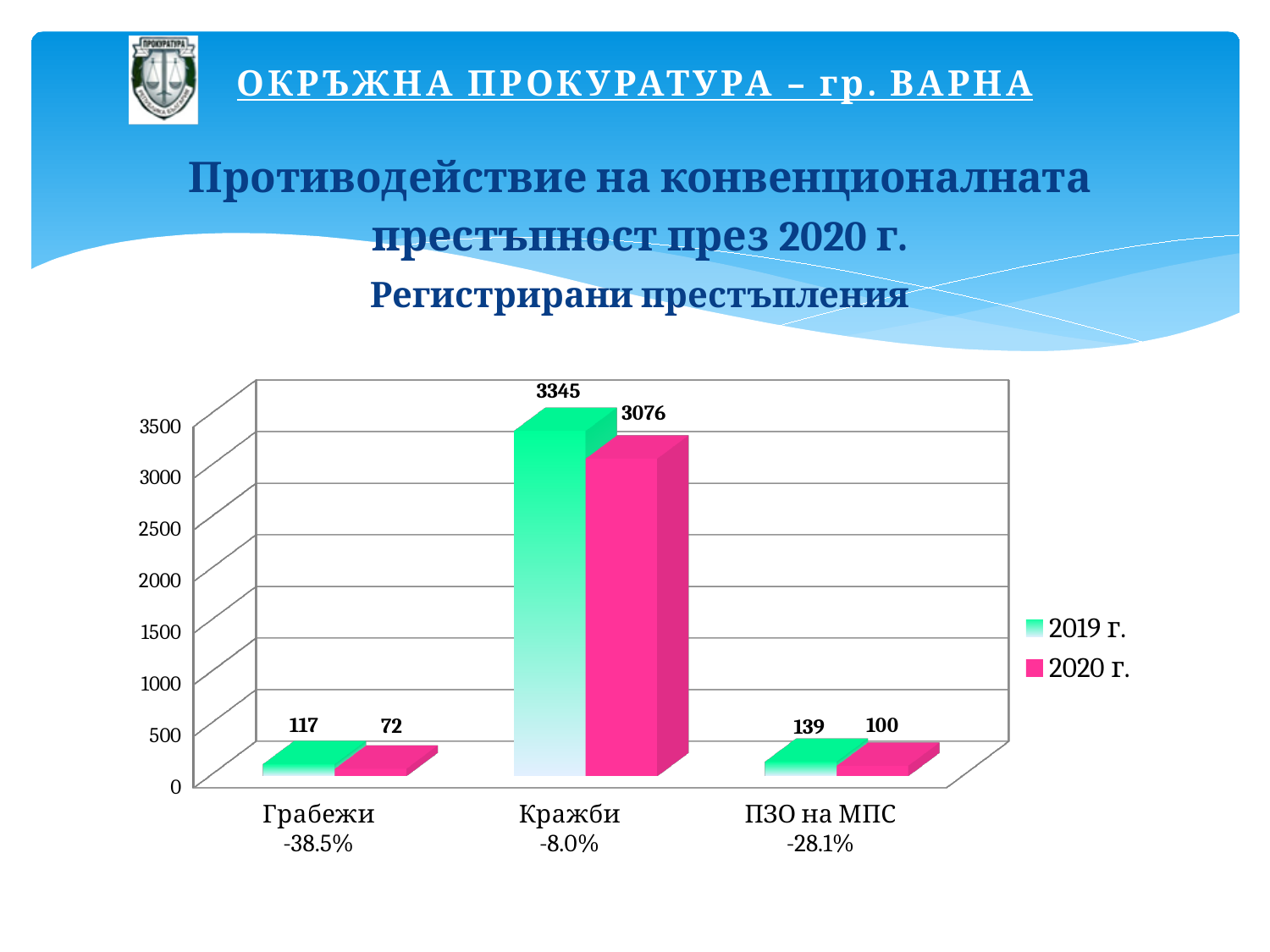
How many categories are shown on the x axis? 3 What kind of chart is shown on the slide? bar chart What is the value for Грабежи in 2019 г.? 117 What is the value for ПЗО на МПС in 2020 г.? 100 Which is larger for ПЗО на МПС: the 2019 г. value or the 2020 г. value? 2019 г. What is the value for ПЗО на МПС in 2019 г.? 139 What is the difference between the 2019 г. and 2020 г. values for Грабежи? 45 What is the difference between the 2019 г. and 2020 г. values for Кражби? 269 How many series does the legend list? 2 Which category has the lowest value in 2020 г.? Грабежи What is the value for Кражби in 2020 г.? 3076 Which category has the highest value in 2019 г.? Кражби